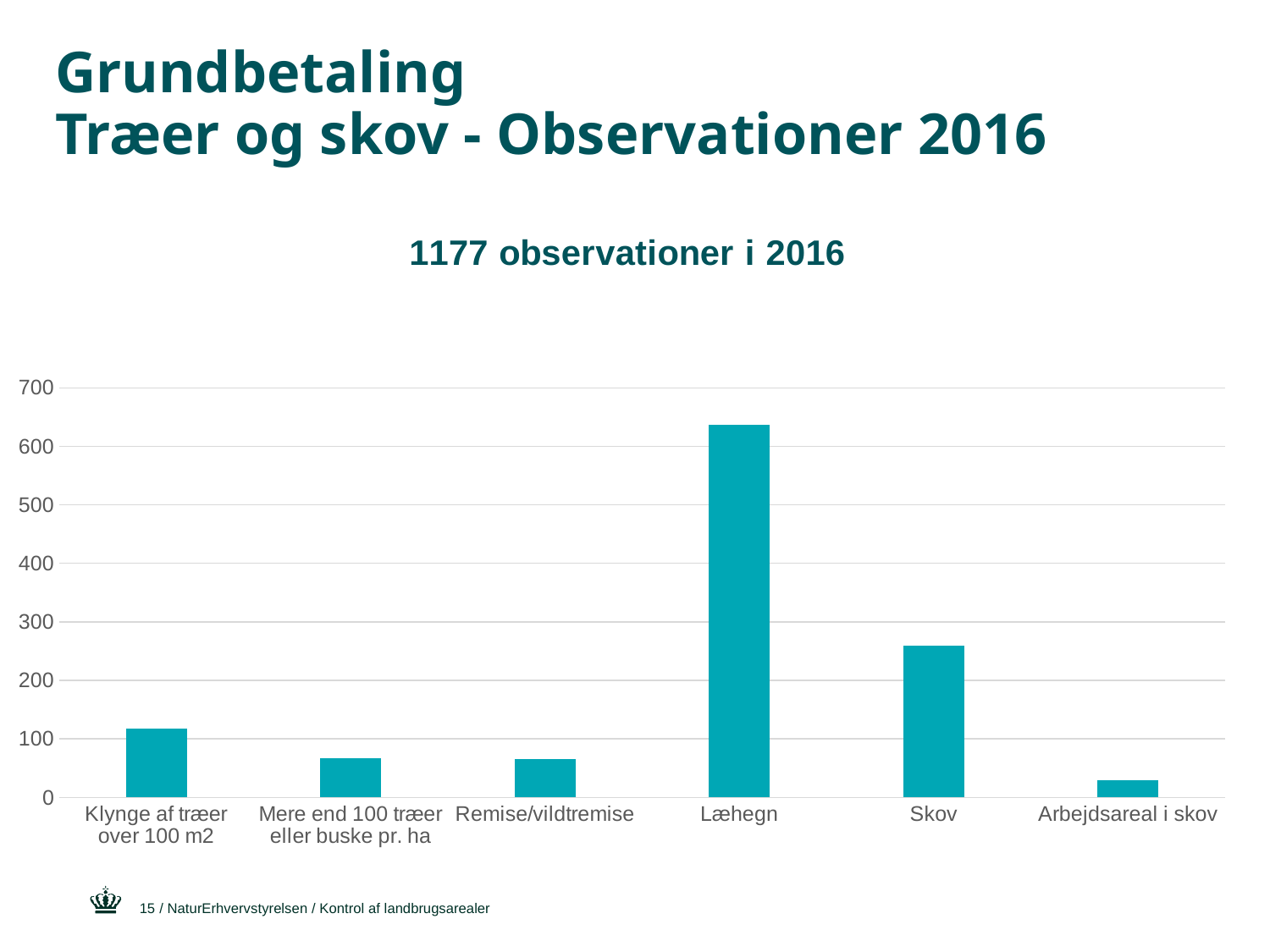
Is the value for Skov greater or less than 200? greater Is the value for Arbejdsareal i skov greater or less than 100? less How many categories are shown on the x axis of the chart? 6 Which category has the highest value in the chart? Læhegn Which is larger, the value for Skov or the value for Klynge af træer over 100 m2? Skov Is the value for Skov greater or less than 300? less What is the total number of observations in 2016 stated above the chart? 1177 Which category has the lowest value in the chart? Arbejdsareal i skov What kind of chart is shown on the slide? bar chart Which is larger, the value for Remise/vildtremise or the value for Arbejdsareal i skov? Remise/vildtremise